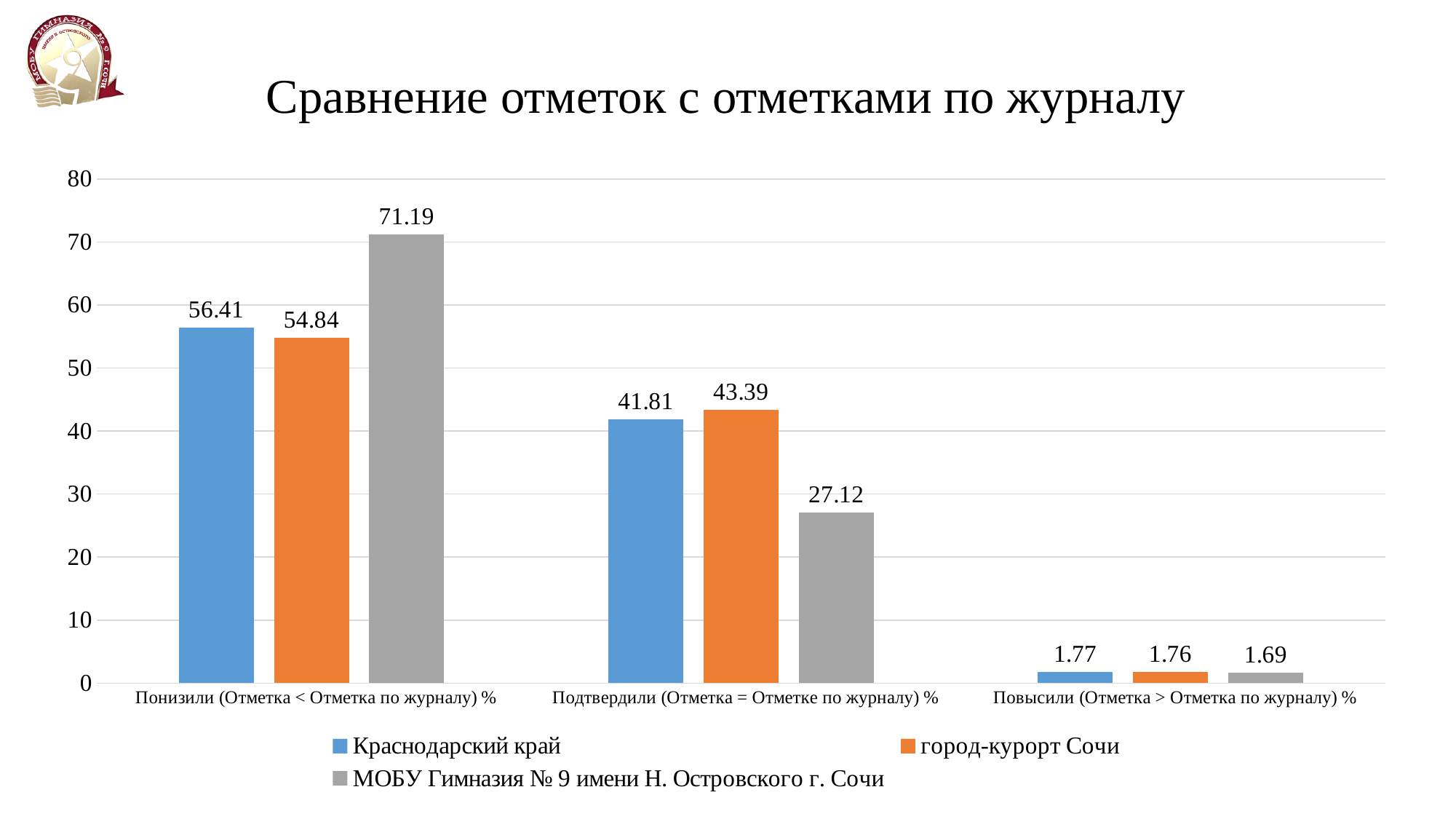
How many categories are shown on the x axis? 3 What is the value for город-курорт Сочи in the category Повысили (Отметка > Отметка по журналу) %? 1.76 In the category Подтвердили (Отметка = Отметке по журналу) %, which is larger: Краснодарский край or город-курорт Сочи? город-курорт Сочи What is the difference between the город-курорт Сочи value and the МОБУ Гимназия № 9 value in the category Подтвердили (Отметка = Отметке по журналу) %? 16.27 How many series does the legend list? 3 What is the value for Краснодарский край in the category Подтвердили (Отметка = Отметке по журналу) %? 41.81 Which series has the lowest value in the category Подтвердили (Отметка = Отметке по журналу) %? МОБУ Гимназия № 9 имени Н. Островского г. Сочи What is the value for МОБУ Гимназия № 9 имени Н. Островского г. Сочи in the category Понизили (Отметка < Отметка по журналу) %? 71.19 Which series has the highest value in the category Понизили (Отметка < Отметка по журналу) %? МОБУ Гимназия № 9 имени Н. Островского г. Сочи Is the value for МОБУ Гимназия № 9 in the category Понизили (Отметка < Отметка по журналу) % greater or less than 70? greater What type of chart is shown on the slide? Bar chart What is the difference between the МОБУ Гимназия № 9 value and the Краснодарский край value in the category Понизили (Отметка < Отметка по журналу) %? 14.78